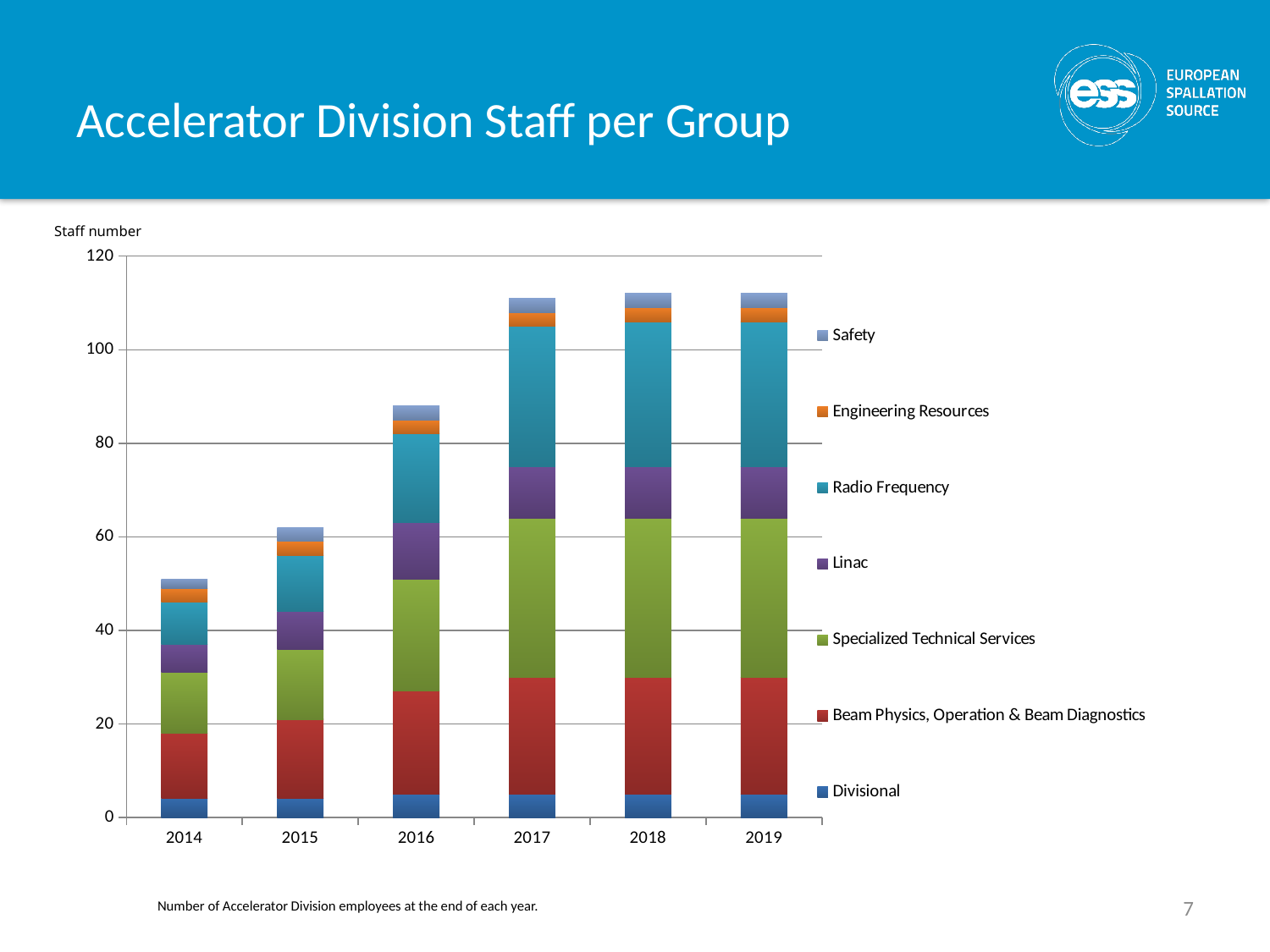
How many series does the chart's legend list? 7 Is the total staff number for 2014 greater or less than 60? less Which year has the lowest total staff number? 2014 Is the total staff number for 2016 greater or less than 80? greater Is the total staff number for 2015 greater or less than 80? less Which series is listed at the bottom of the chart's legend? Divisional What kind of chart is shown on the slide? stacked bar chart How many years are shown on the x axis of the chart? 6 What is the title of the slide containing the chart? Accelerator Division Staff per Group Which year has the larger total staff number, 2016 or 2017? 2017 Does the total staff number rise or fall from 2014 to 2017? rise